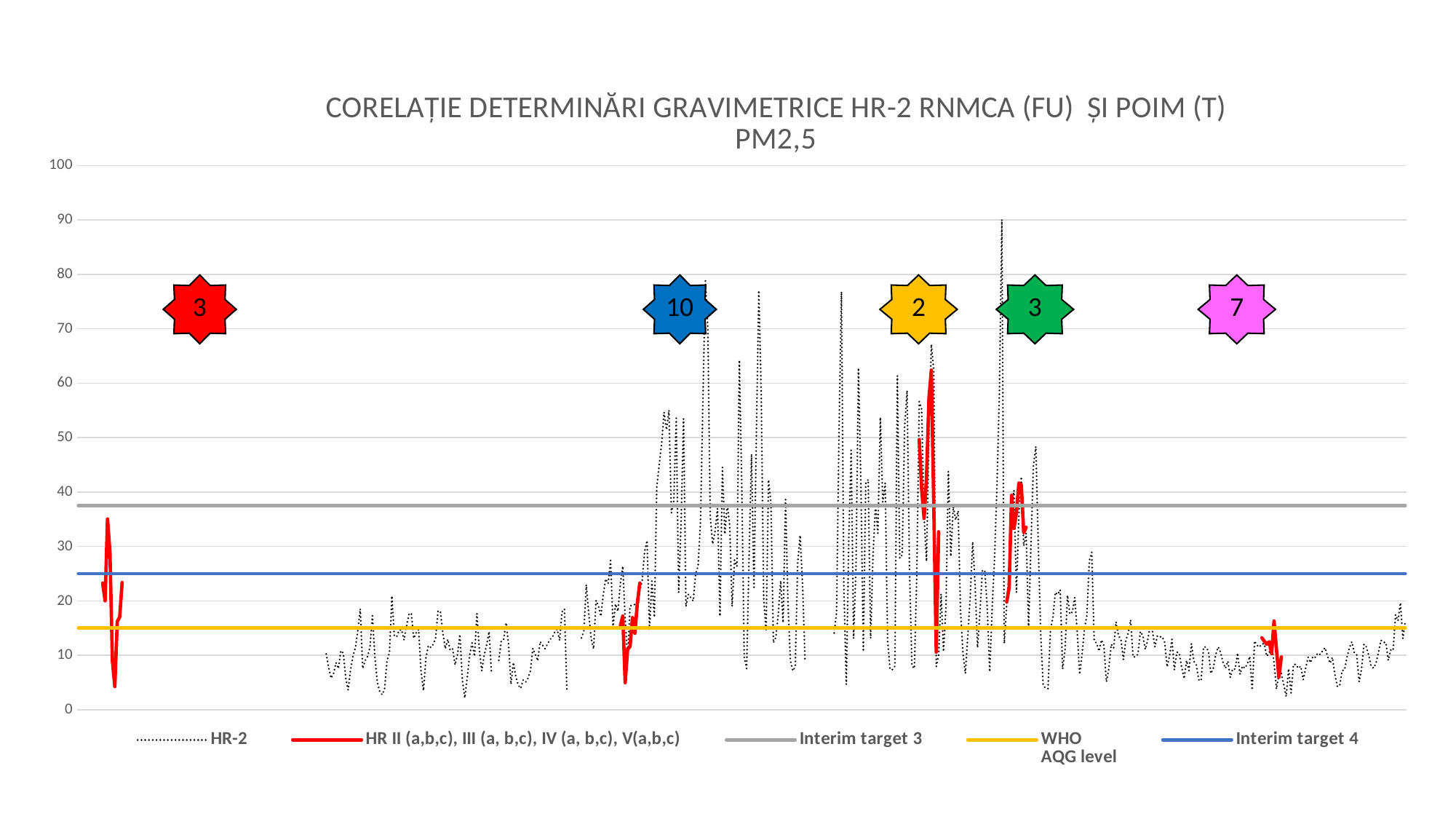
Is the value of the WHO AQG level line greater or less than 20? less Is the highest peak of the HR-2 series greater or less than 80? greater Which horizontal reference line is the lowest on the chart? WHO AQG level How many series does the legend list? 5 Which series is drawn as a dotted black line? HR-2 Is the value of the Interim target 3 line greater or less than 30? greater What is the title of the chart? CORELAȚIE DETERMINĂRI GRAVIMETRICE HR-2 RNMCA (FU) ȘI POIM (T) PM2,5 What is the maximum value shown on the vertical axis? 100 Which horizontal reference line is the highest on the chart? Interim target 3 What kind of chart is shown on the slide? line chart Which horizontal reference line is higher, Interim target 3 or Interim target 4? Interim target 3